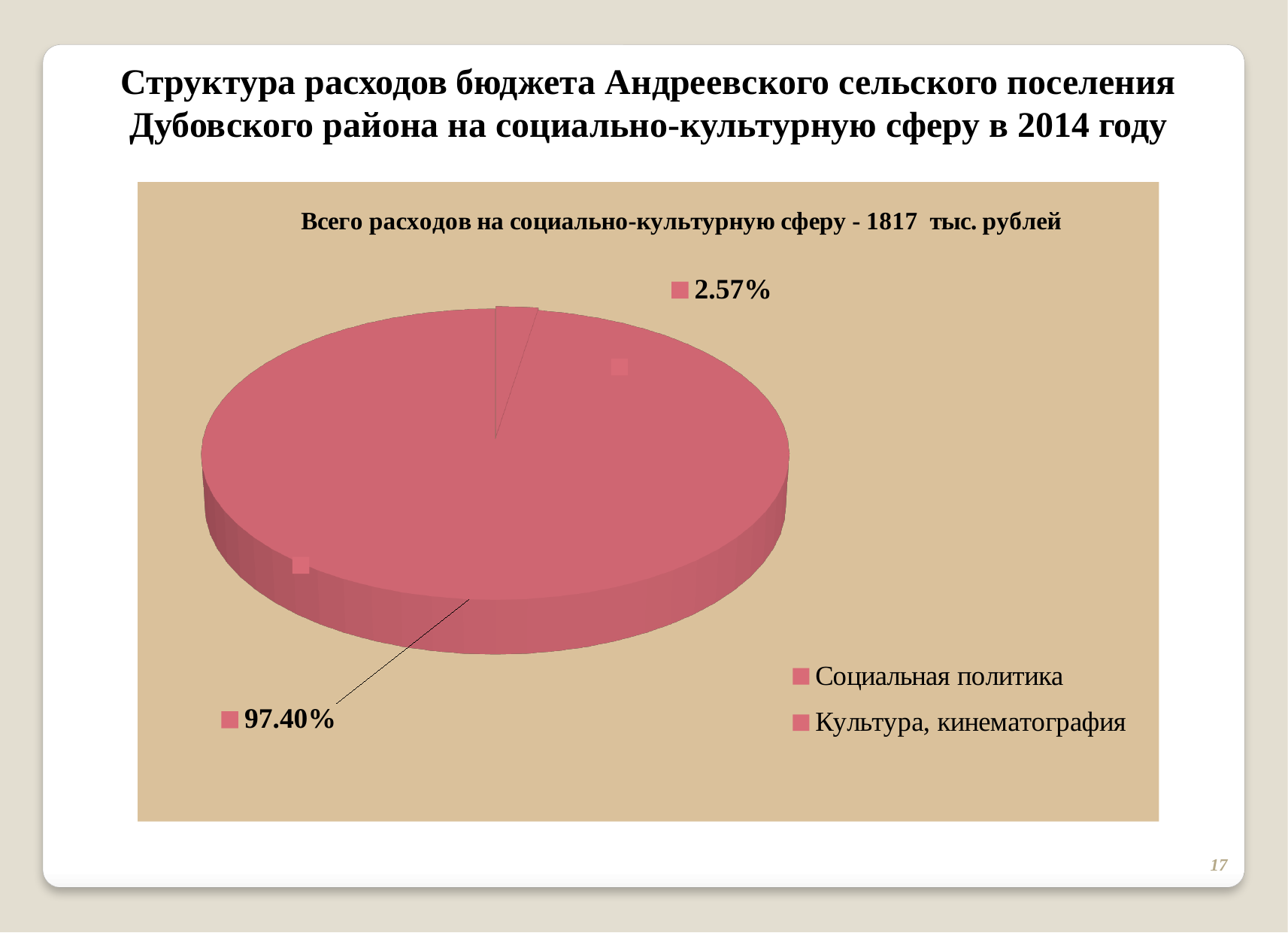
Is the smallest slice of the pie chart greater or less than 10%? less What kind of chart is shown on the slide? pie chart What share of the pie is labelled for Социальная политика? 2.57% What share of the pie is labelled for Культура, кинематография? 97.40% What is the difference in percentage points between the two slices of the pie chart? 94.83 Which legend entry is listed first in the pie chart's legend? Социальная политика What is the percentage shown for the largest slice of the pie chart? 97.40% Is the largest slice of the pie chart greater or less than 90%? greater What is the percentage shown for the smallest slice of the pie chart? 2.57% How many entries does the legend of the pie chart list? 2 What total amount of expenditure on the social and cultural sphere is stated in the chart title? 1817 тыс. рублей How many slices does the pie chart have? 2